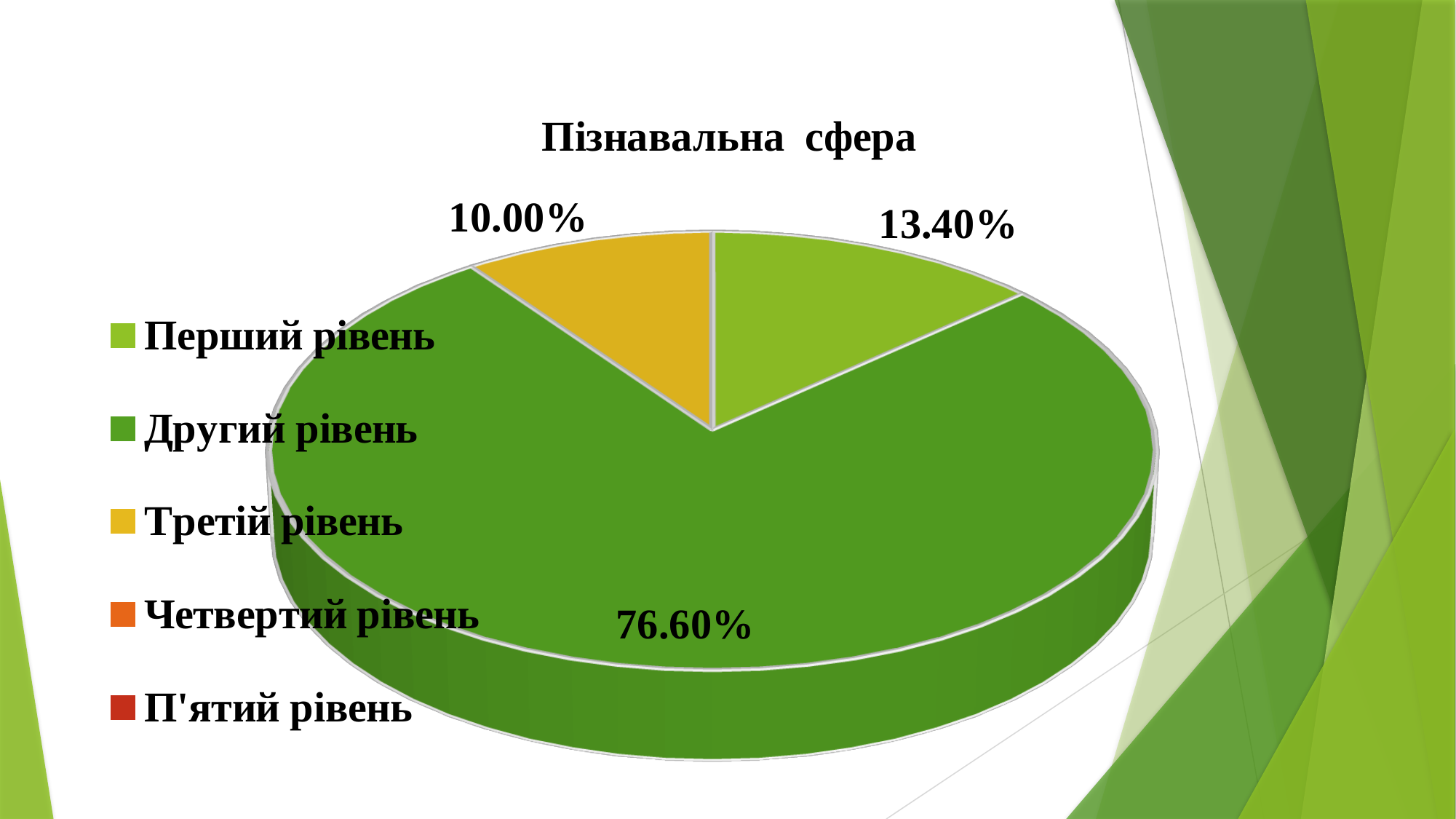
What kind of chart is shown on the slide? pie chart Which of the three labelled slices is the smallest? Третій рівень What percentage is shown for Другий рівень? 76.60% What colour is the slice for Третій рівень? yellow What is the title of the chart? Пізнавальна сфера Which category has the largest slice of the pie? Другий рівень How many entries does the legend list? 5 What percentage is shown for Третій рівень? 10.00% Which is larger, the slice for Перший рівень or the slice for Третій рівень? Перший рівень What is the difference between the percentages for Другий рівень and Перший рівень? 63.20% What percentage is shown for Перший рівень? 13.40% How many slices with data labels are visible in the pie? 3